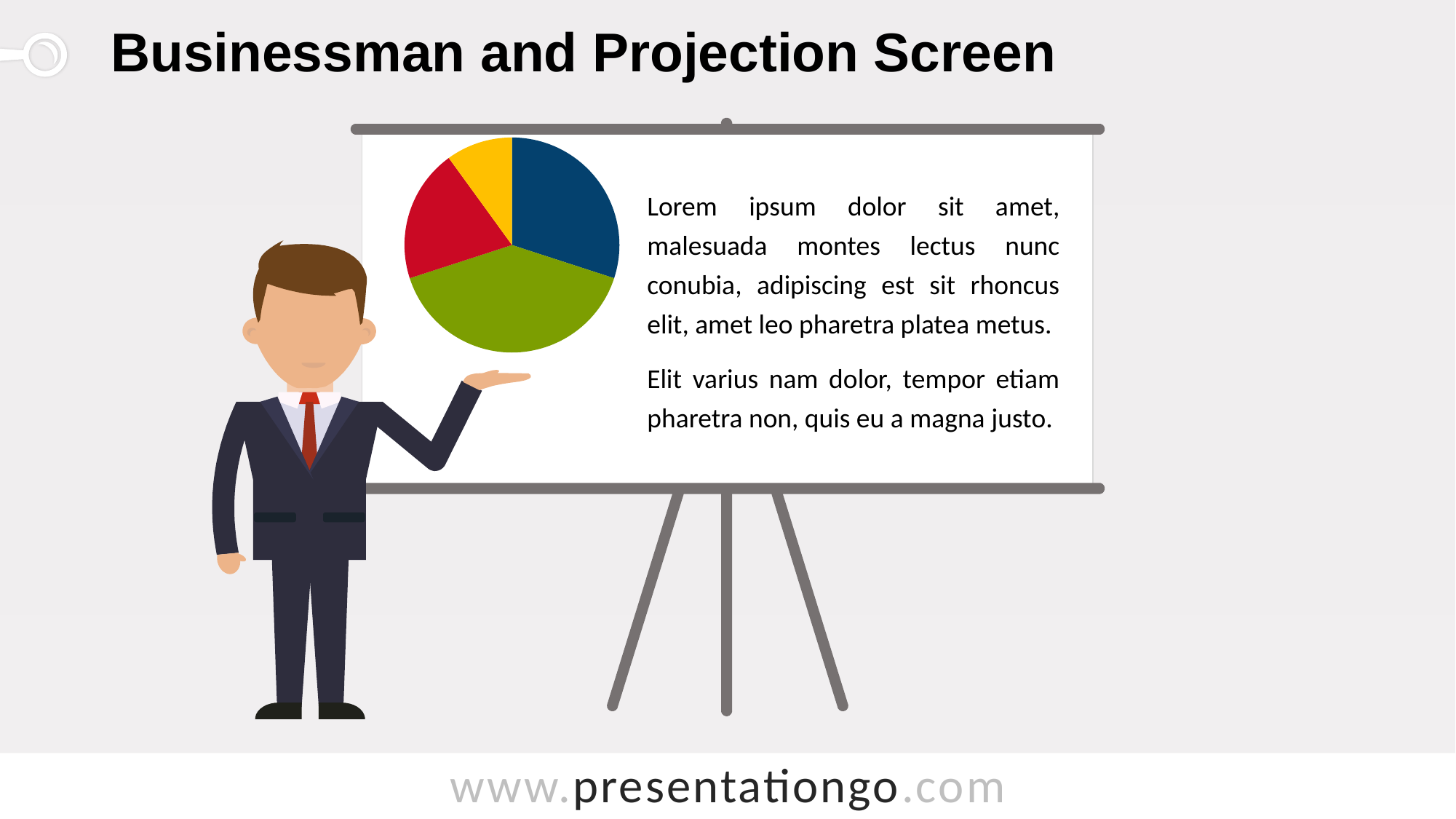
Does the pie chart show any data labels? No Which colour slice is the largest in the pie chart? green Which colour slice is the smallest in the pie chart? yellow Which is larger in the pie chart, the green slice or the yellow slice? green Which is larger in the pie chart, the green slice or the blue slice? green Which is larger in the pie chart, the blue slice or the yellow slice? blue What kind of chart is shown on the projection screen? pie chart Does the pie chart have a legend? No How many slices does the pie chart have? 4